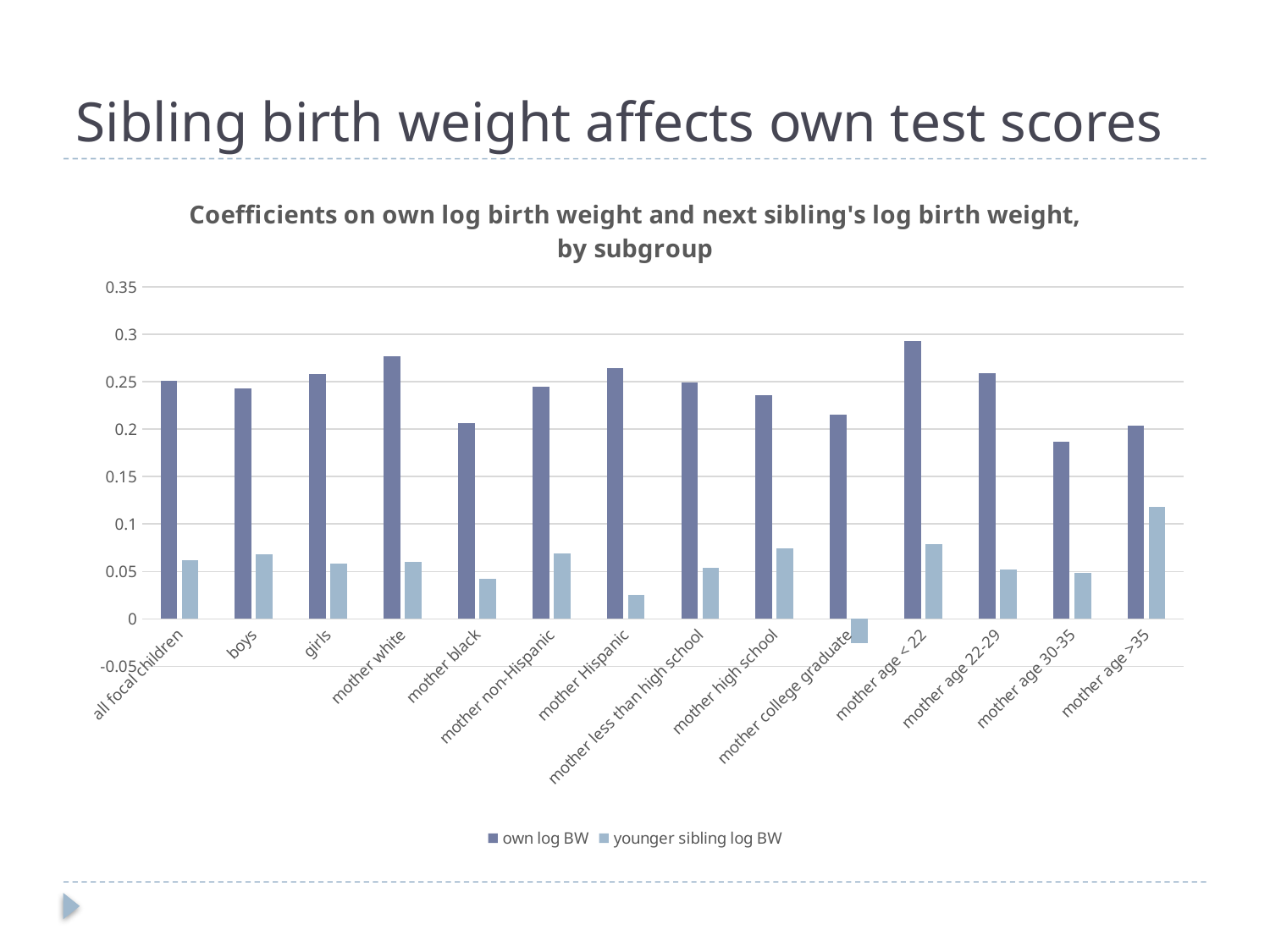
How many subgroups (categories) are shown on the x axis? 14 Which has the larger own log BW value, mother white or mother black? mother white Which subgroup has the highest value for own log BW? mother age < 22 Is the own log BW value for mother age < 22 greater or less than 0.25? greater How many series does the legend list? 2 Is the younger sibling log BW value for mother Hispanic greater or less than 0.05? less What kind of chart is shown on the slide? bar chart Which subgroup has the highest value for younger sibling log BW? mother age >35 Is the own log BW value for mother black greater or less than 0.25? less Which subgroup has the lowest value for younger sibling log BW? mother college graduate Which subgroup has the lowest value for own log BW? mother age 30-35 What is the title of the chart? Coefficients on own log birth weight and next sibling's log birth weight, by subgroup